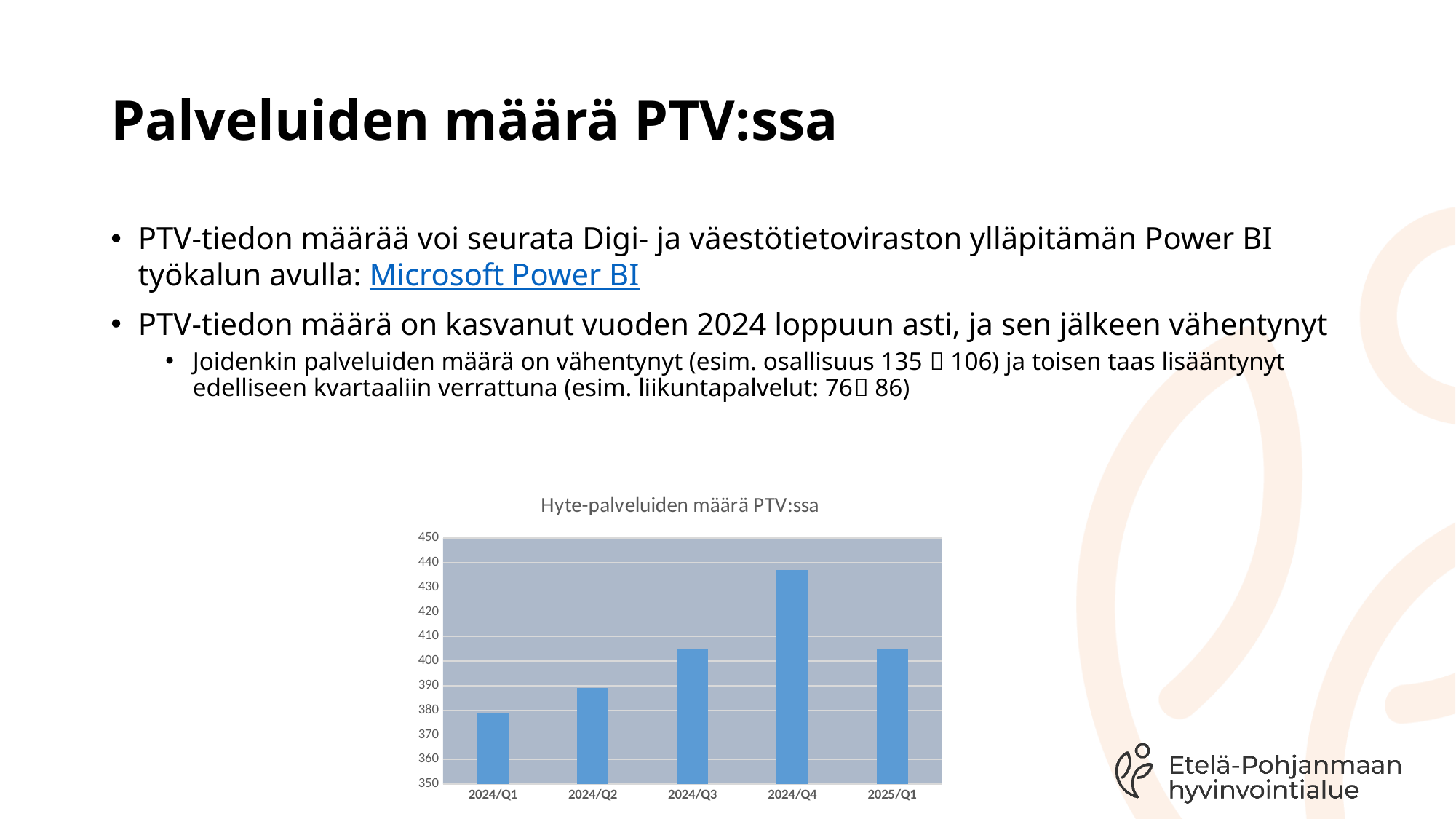
Is the value for 2024/Q2 greater or less than 380? greater What is the title of the chart on the slide? Hyte-palveluiden määrä PTV:ssa Which is larger, the value for 2024/Q2 or the value for 2024/Q3? 2024/Q3 What kind of chart is shown on the slide? bar chart Which quarter has the highest value in the chart? 2024/Q4 Is the value for 2024/Q1 greater or less than 370? greater Is the value for 2025/Q1 greater or less than 420? less How do the values change from 2024/Q1 to 2025/Q1 along the x axis? They rise until 2024/Q4, then fall in 2025/Q1 How many quarters are plotted in the chart? 5 Which quarter has the lowest value in the chart? 2024/Q1